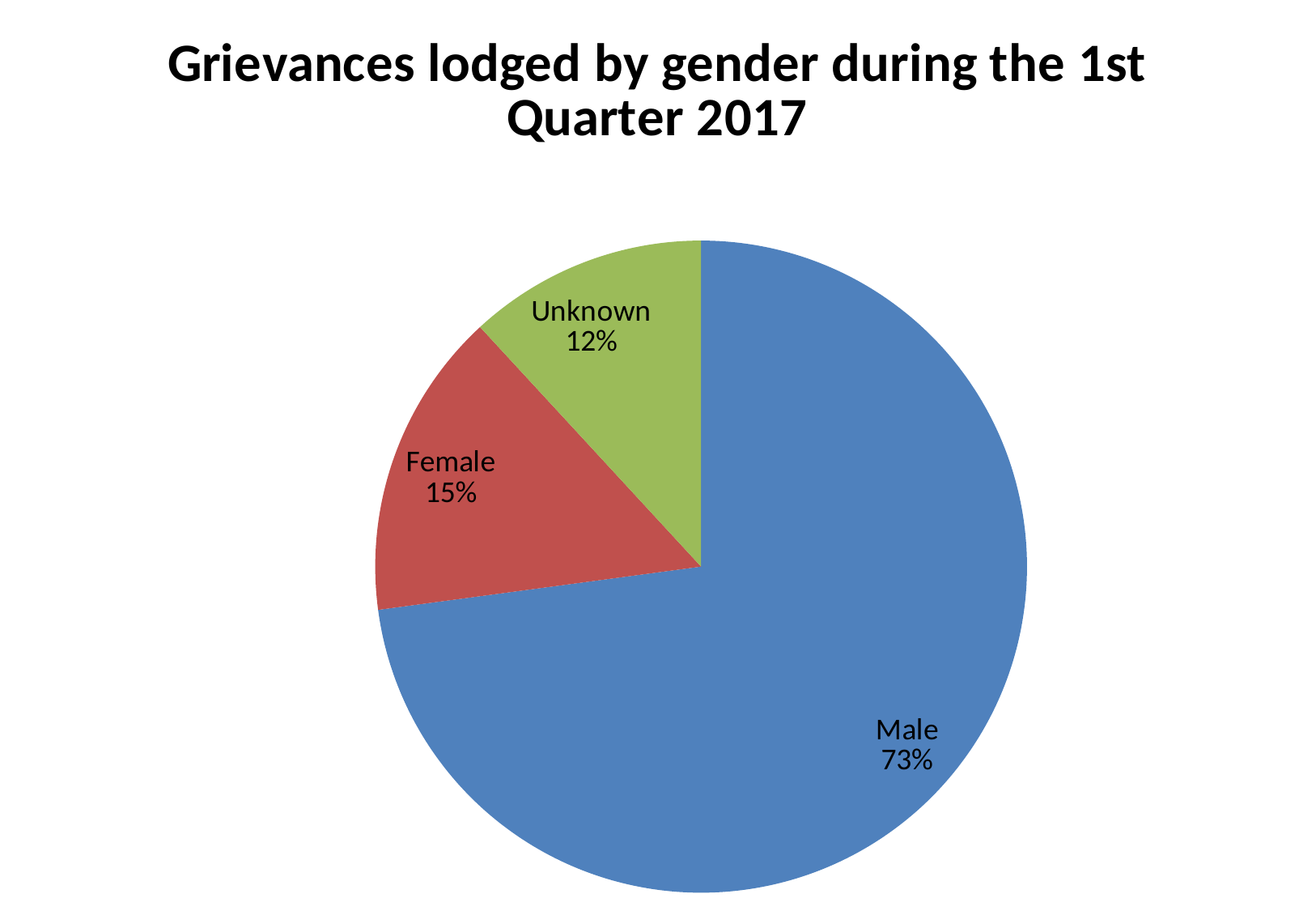
What colour is the Male slice of the pie? blue What share of grievances were lodged by males? 73% What is the title of the chart? Grievances lodged by gender during the 1st Quarter 2017 What is the difference in percentage points between the Female and Unknown shares? 3 What share of grievances were lodged by people of unknown gender? 12% What kind of chart is shown on the slide? pie chart Which is larger, the Female share or the Unknown share? Female How many categories are shown in the pie chart? 3 What share of grievances were lodged by females? 15% What is the difference in percentage points between the Male and Female shares? 58 Which category has the smallest share of the pie? Unknown Which category has the largest share of the pie? Male